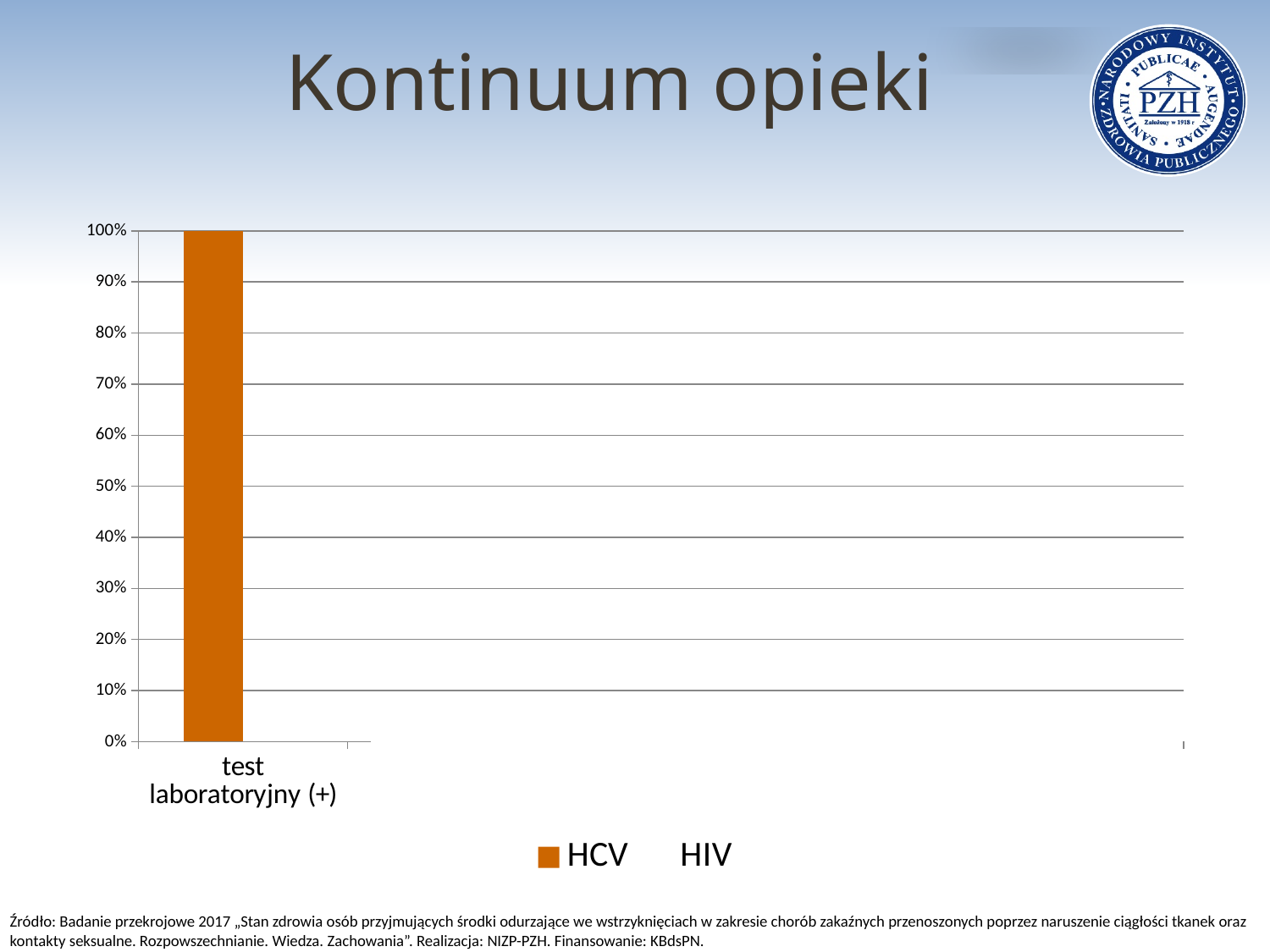
What kind of chart is shown on the slide? bar chart Is the HCV value for "test laboratoryjny (+)" greater or less than 90%? greater What colour is the HCV series in the chart? orange Which series are listed in the chart legend? HCV and HIV What is the value of the HCV bar for "test laboratoryjny (+)"? 100% What is the title of the slide containing the chart? Kontinuum opieki Is the HCV value for "test laboratoryjny (+)" greater or less than 50%? greater How many series does the legend list? 2